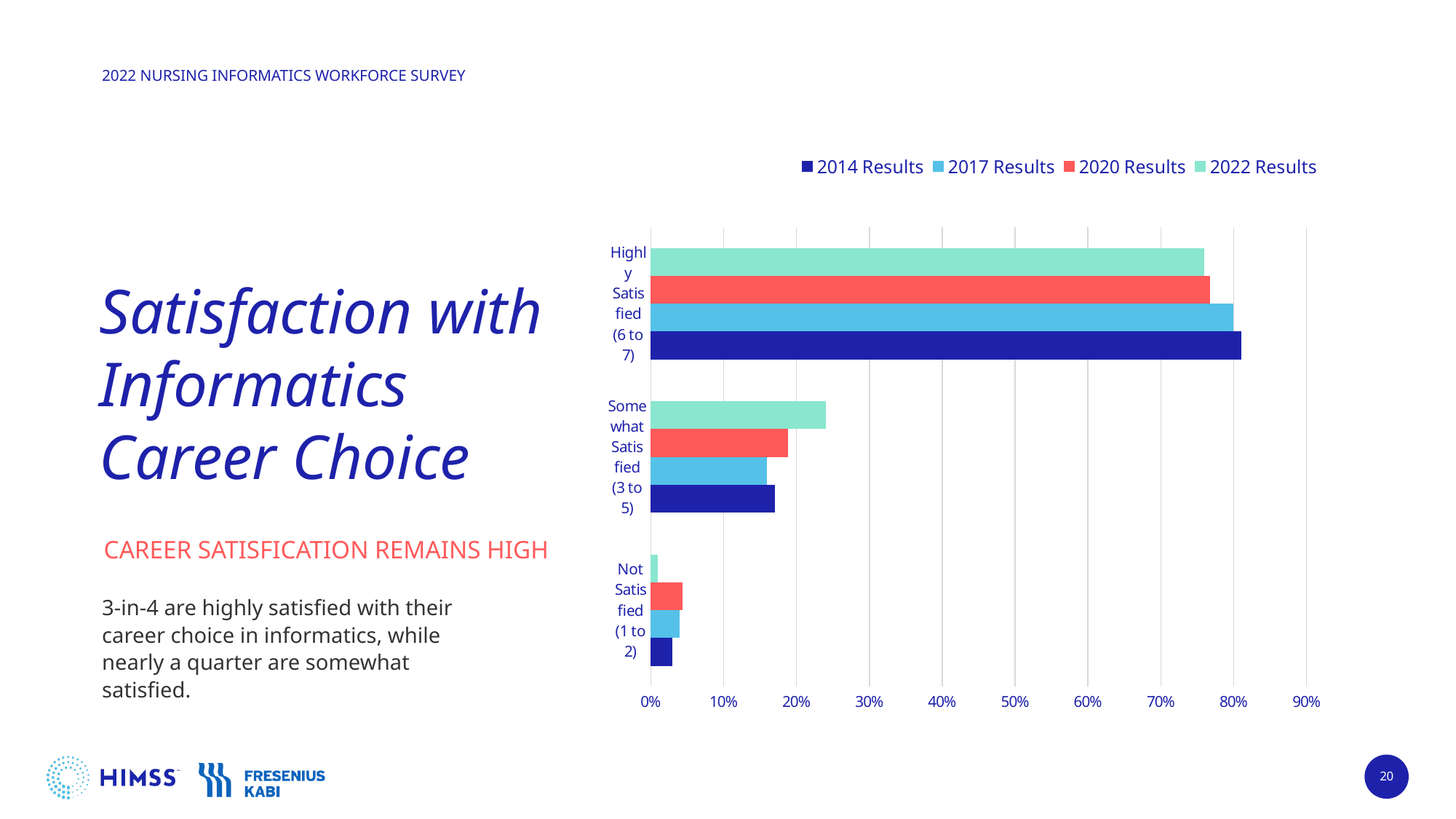
Is the 2020 Results value for Not Satisfied (1 to 2) greater or less than 10%? less How many series does the legend list? 4 How many satisfaction categories are plotted on the chart? 3 Which category has the highest 2022 Results value? Highly Satisfied (6 to 7) What kind of chart is shown on the slide? Bar chart Is the 2022 Results value for Highly Satisfied (6 to 7) greater or less than 70%? greater Which category has the lowest 2022 Results value? Not Satisfied (1 to 2) Is the 2020 Results value for Highly Satisfied (6 to 7) greater or less than 80%? less For Somewhat Satisfied (3 to 5), which survey year has the highest value? 2022 Results For Not Satisfied (1 to 2), which is larger: the 2020 Results value or the 2022 Results value? 2020 Results